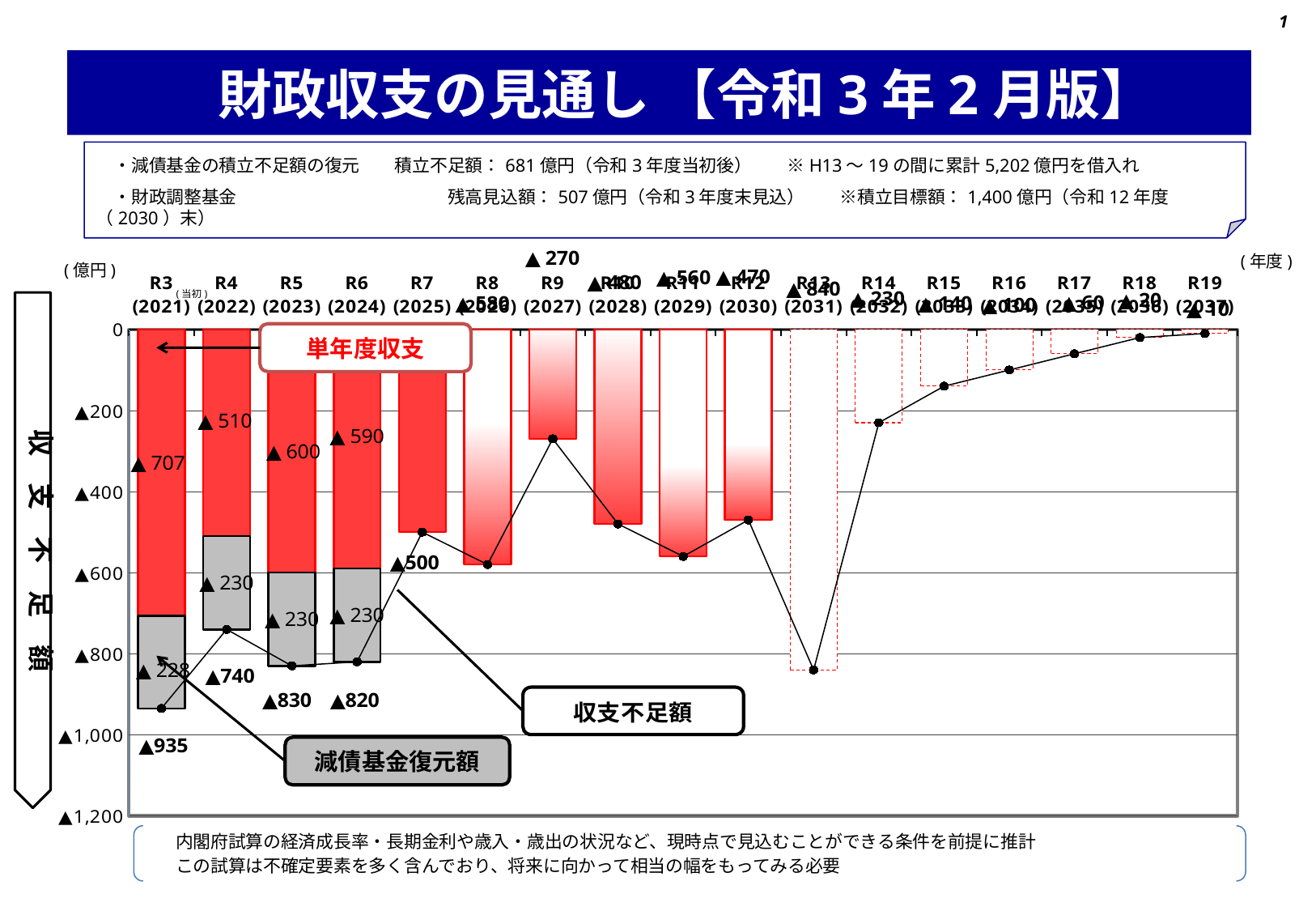
R6（2024）の積み上げ棒（単年度収支＋減債基金復元額）の合計はいくらですか？ ▲820 R3（2021）の単年度収支の値はいくらですか？ ▲707 R9（2027）の収支不足額はいくらですか？ ▲270 R13（2031）の収支不足額はいくらですか？ ▲840 R3からR6のうち、収支不足額が最も小さい年度はどれですか？ R4（2022） 収支不足額が最も大きい年度はどれですか？ R3（2021） グラフには何年度分のデータが示されていますか？ 17 R3（2021）の収支不足額はいくらですか？ ▲935 R14からR19にかけて、収支不足額は増加していますか、減少していますか？ 減少 R3（2021）の減債基金復元額はいくらですか？ ▲228 単年度収支の絶対値は、R3とR4のどちらが大きいですか？ R3（2021） R3とR4の収支不足額の差はいくらですか？ 195